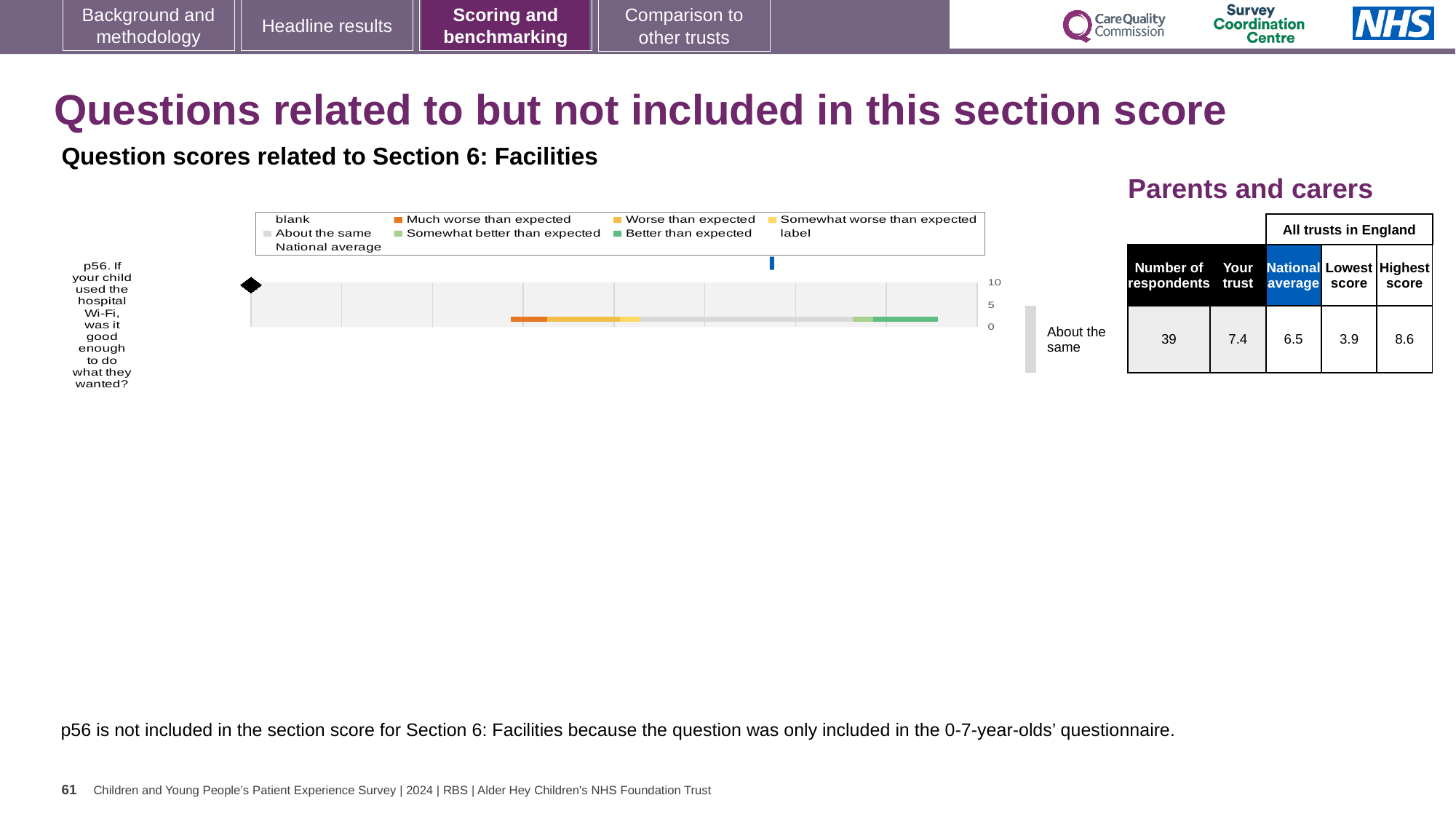
How many questions (categories) are plotted in the chart? 1 In the table next to the chart, what is the highest score among all trusts in England for p56? 8.6 In the table next to the chart, what is the national average score for p56? 6.5 Which question is plotted in the chart? p56. If your child used the hospital Wi-Fi, was it good enough to do what they wanted? In the legend, what colour represents 'Much worse than expected'? orange Which is larger for p56: the 'Your trust' score or the national average? Your trust In the table next to the chart, what is the 'Your trust' score for p56? 7.4 What is the difference between the highest and lowest scores among all trusts in England for p56? 4.7 What kind of chart is shown on the slide for question p56? bar chart What is the difference between the 'Your trust' score and the national average for p56? 0.9 In the table next to the chart, how many respondents answered p56? 39 In the table next to the chart, what is the lowest score among all trusts in England for p56? 3.9